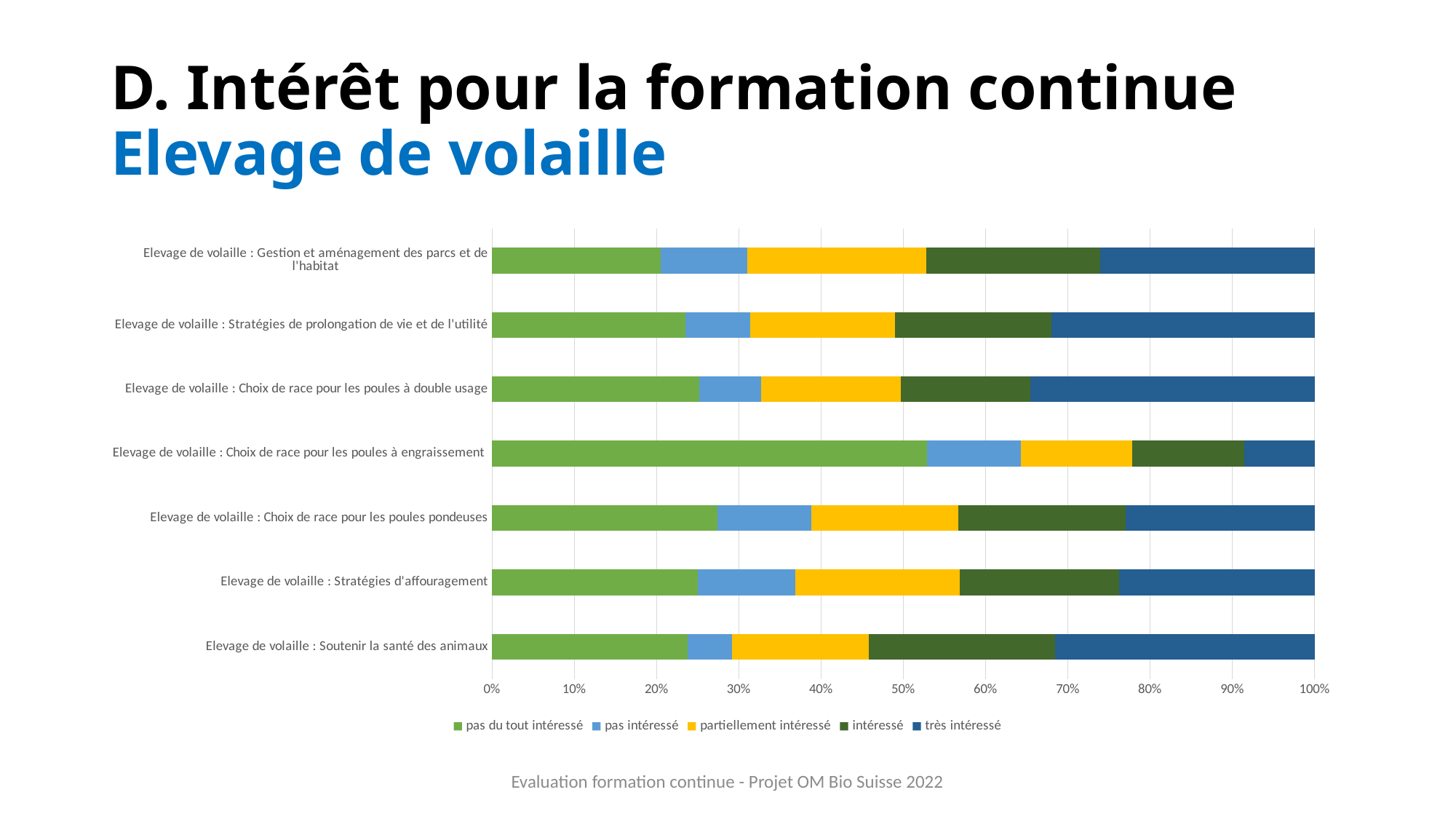
Which category has the largest share of 'pas du tout intéressé'? Elevage de volaille : Choix de race pour les poules à engraissement Is the 'pas du tout intéressé' share for 'Choix de race pour les poules pondeuses' greater or less than 20%? greater How many series does the legend list? 5 What kind of chart is shown on the slide? Stacked bar chart Is the 'pas du tout intéressé' share for 'Soutenir la santé des animaux' greater or less than 30%? less Which category has the smallest share of 'très intéressé'? Elevage de volaille : Choix de race pour les poules à engraissement Which category has the smallest share of 'pas intéressé'? Elevage de volaille : Soutenir la santé des animaux What is the highest value shown on the horizontal axis? 100% How many categories (training topics) are plotted on the chart? 7 What is the last entry listed in the chart legend? très intéressé Which has a larger 'pas du tout intéressé' share: 'Choix de race pour les poules à engraissement' or 'Choix de race pour les poules pondeuses'? Elevage de volaille : Choix de race pour les poules à engraissement Is the 'pas du tout intéressé' share for 'Choix de race pour les poules à engraissement' greater or less than 50%? greater